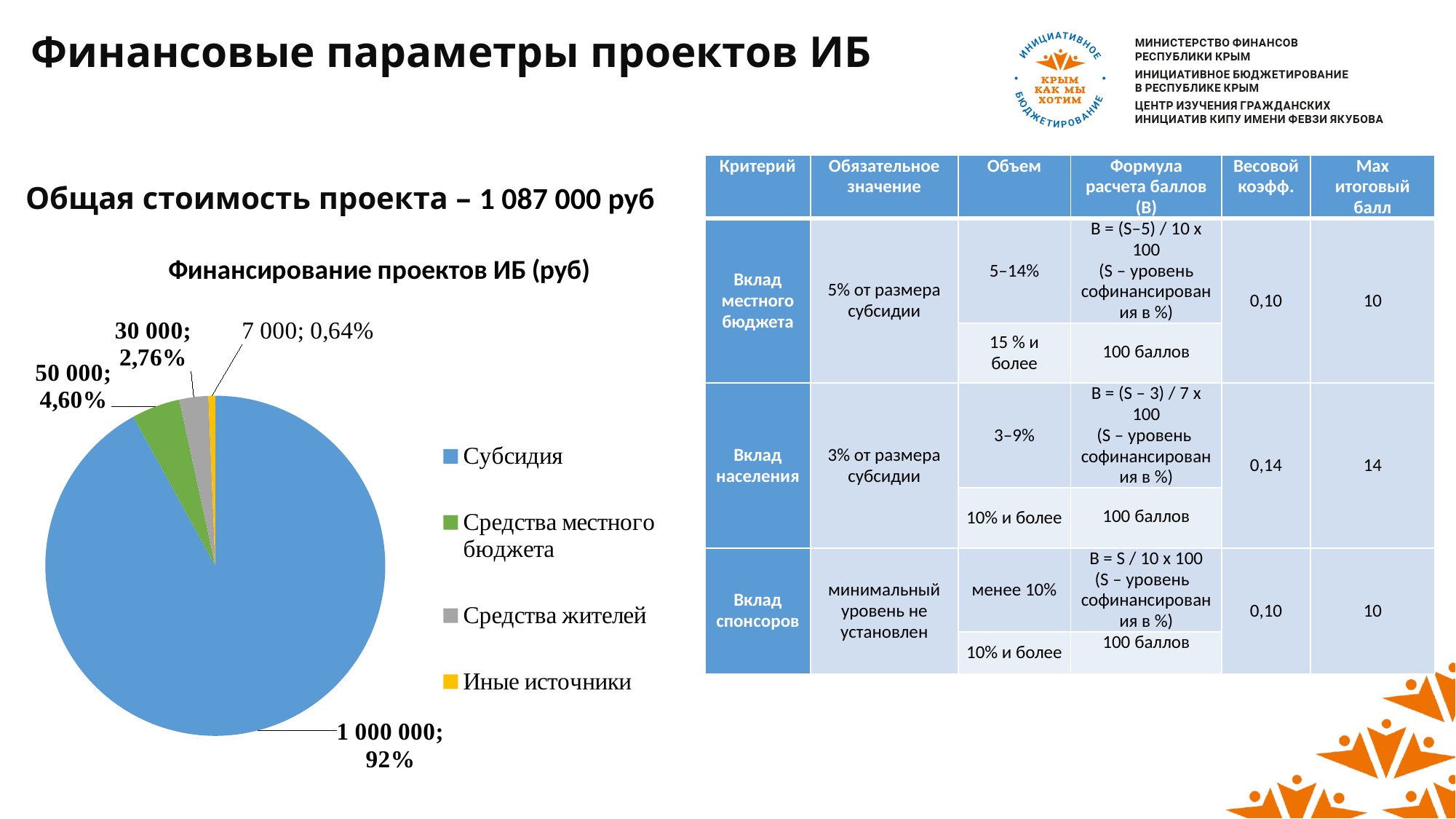
What is the value for Средства местного бюджета? 50 000 What type of chart is shown on the slide? Pie chart What is the value for Средства жителей? 30 000 Which category has the largest slice? Субсидия What is the value for Иные источники? 7 000 What is the title of the chart? Финансирование проектов ИБ (руб) How many slices does the pie chart have? 4 What share of the pie does Субсидия represent? 92% What is the value for Субсидия? 1 000 000 Which category has the smallest slice? Иные источники What is the difference between the values for Средства местного бюджета and Средства жителей? 20 000 What share of the pie does Средства жителей represent? 2,76%